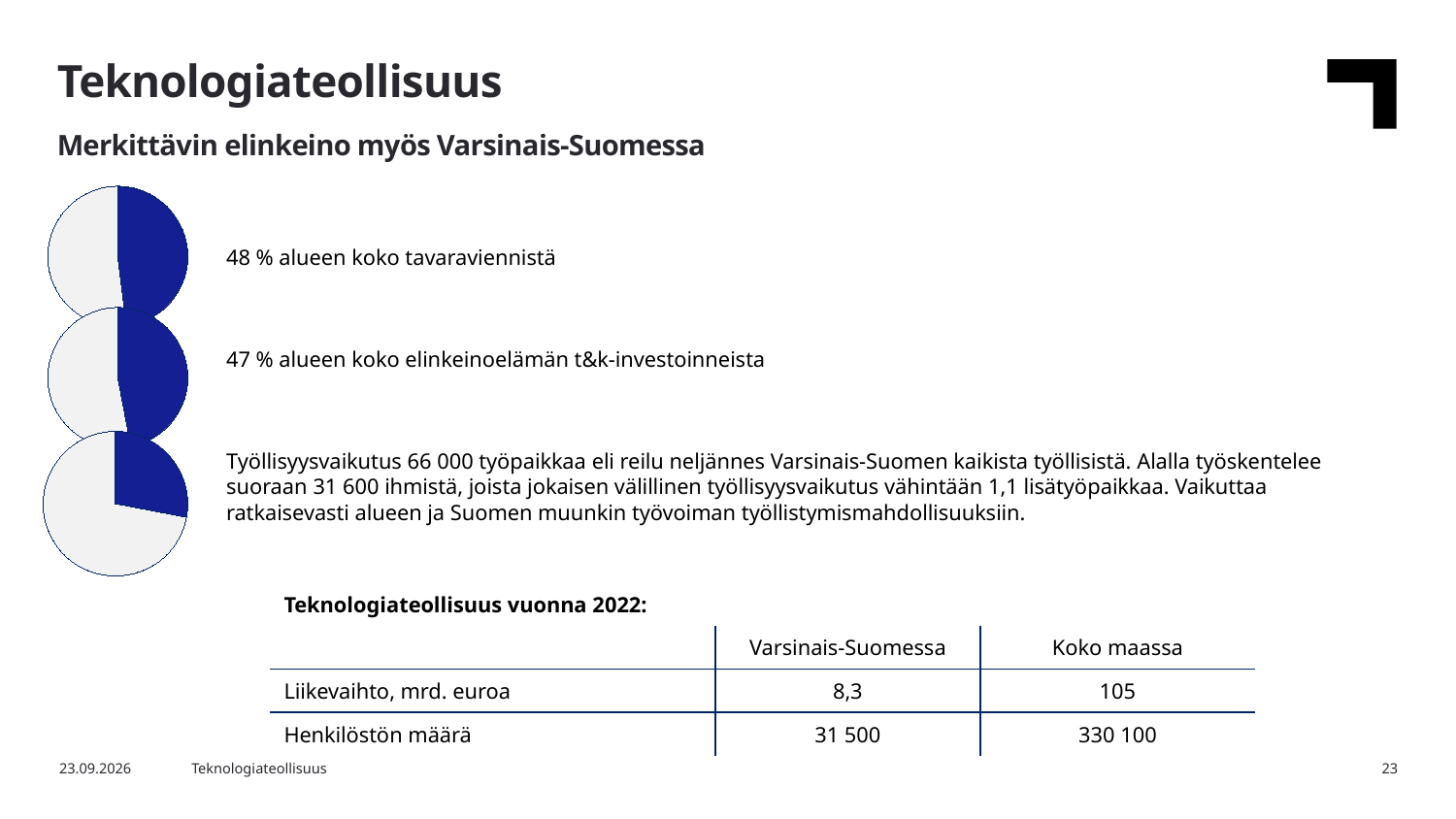
Which pie chart has the larger blue slice, the top one or the bottom one? The top one What does the top pie chart's blue slice represent, according to the text next to it? 48 % alueen koko tavaraviennistä In the middle pie chart, what share does the blue slice represent (share of the region's business R&D investments)? 47 % How many slices does each pie chart have? 2 What colour is the highlighted slice in each pie chart? Blue What kind of charts are shown on the left side of the slide? Pie charts How many pie charts are on the slide? 3 Is the blue slice in the bottom pie chart greater or less than half of the pie? less Which pie chart has the smaller blue slice, the middle one or the bottom one? The bottom one In the top pie chart, what share does the blue slice represent (share of the region's total goods exports)? 48 %